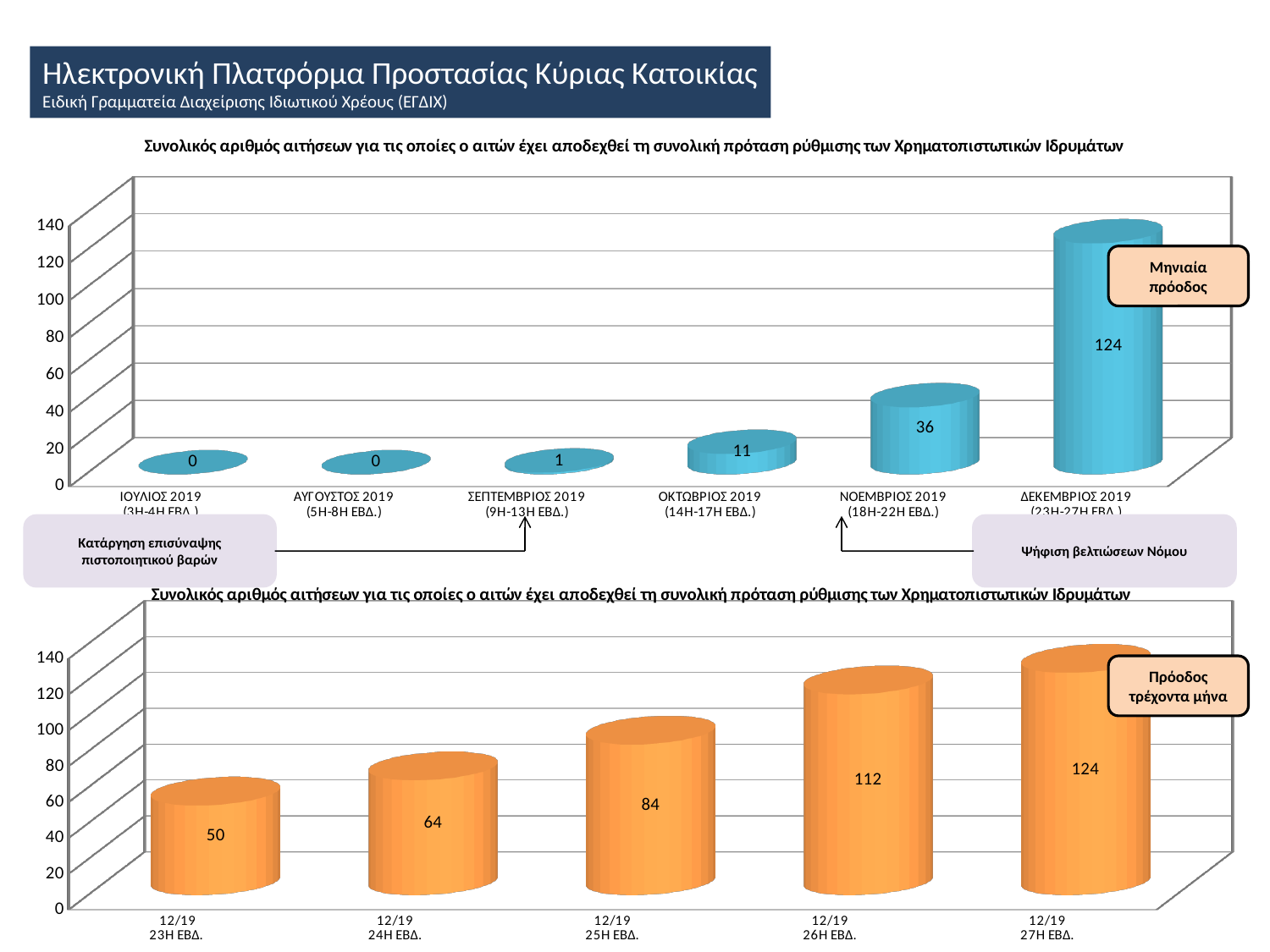
On the top chart, do the values rise or fall from ΙΟΥΛΙΟΣ 2019 to ΔΕΚΕΜΒΡΙΟΣ 2019? rise On the bottom chart, what is the difference between the values for 12/19 26Η ΕΒΔ. and 12/19 24Η ΕΒΔ.? 48 On the top chart, what is the difference between the values for ΔΕΚΕΜΒΡΙΟΣ 2019 and ΝΟΕΜΒΡΙΟΣ 2019? 88 On the top chart, how many months are plotted? 6 On the top chart, what is the value for ΔΕΚΕΜΒΡΙΟΣ 2019? 124 On the bottom chart, what is the value for 12/19 23Η ΕΒΔ.? 50 On the bottom chart, what is the value for 12/19 25Η ΕΒΔ.? 84 On the bottom chart, which week has the lowest value? 12/19 23Η ΕΒΔ. On the top chart, what is the value for ΟΚΤΩΒΡΙΟΣ 2019? 11 On the top chart, which month has the highest value? ΔΕΚΕΜΒΡΙΟΣ 2019 What kind of chart is the bottom chart? bar chart On the top chart, what is the value for ΝΟΕΜΒΡΙΟΣ 2019? 36